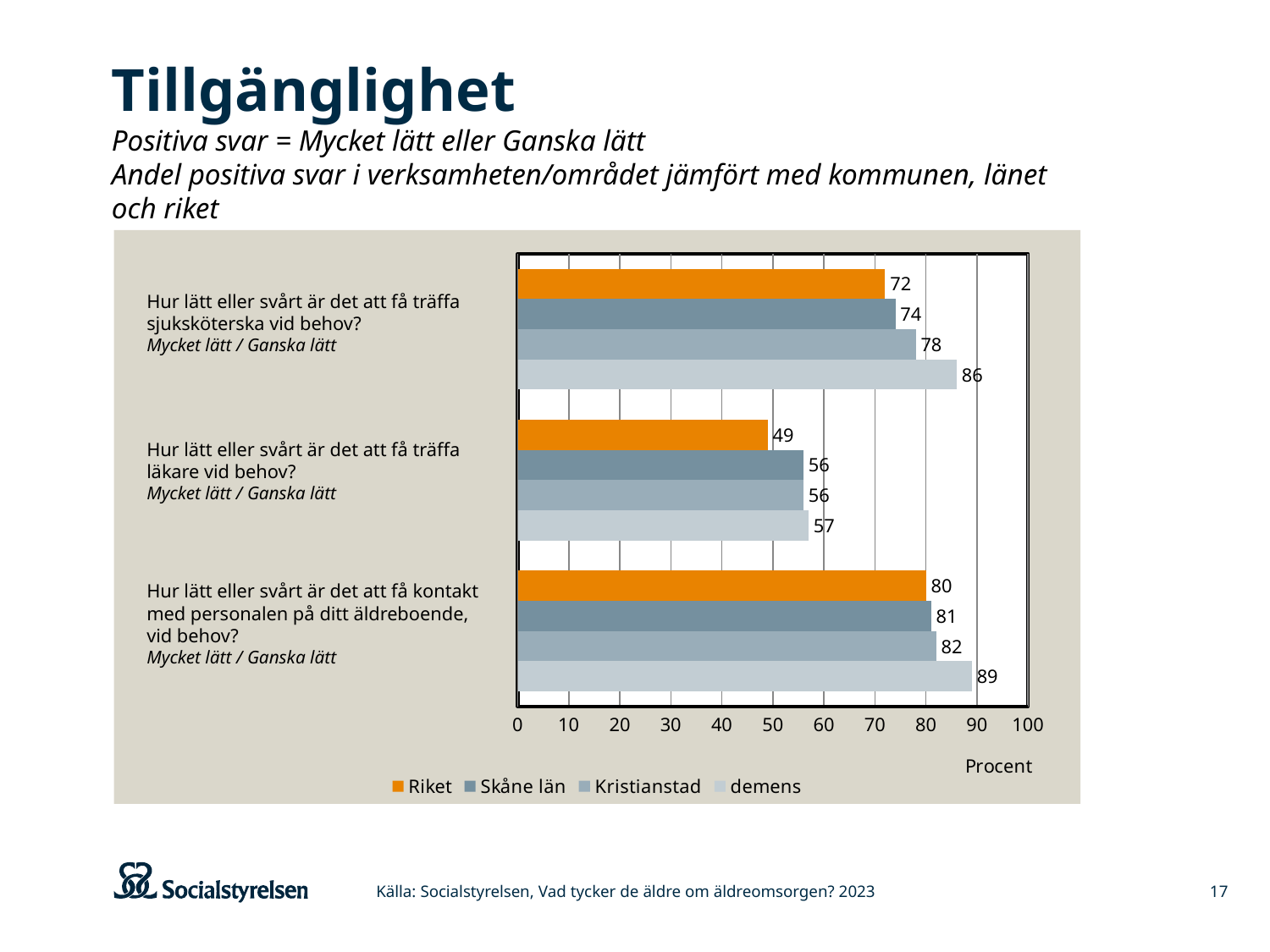
How many series does the legend list? 4 Which series has the lowest value for the question about meeting a doctor (läkare) when needed? Riket Which series is shown in orange in the legend? Riket How many question categories are shown on the chart? 3 Which series has the highest value for the question about getting in contact with staff at the äldreboende? demens What is the value for Riket for the question about meeting a nurse (sjuksköterska) when needed? 72 What kind of chart is shown on the slide? Bar chart Which is larger: the Skåne län value for meeting a nurse (sjuksköterska) or the Skåne län value for meeting a doctor (läkare)? Meeting a nurse (sjuksköterska) What is the label on the horizontal axis? Procent What is the value for Kristianstad for the question about getting in contact with staff at the äldreboende? 82 What is the value for demens for the question about meeting a doctor (läkare) when needed? 57 What is the difference between the demens value and the Riket value for the question about meeting a nurse (sjuksköterska)? 14